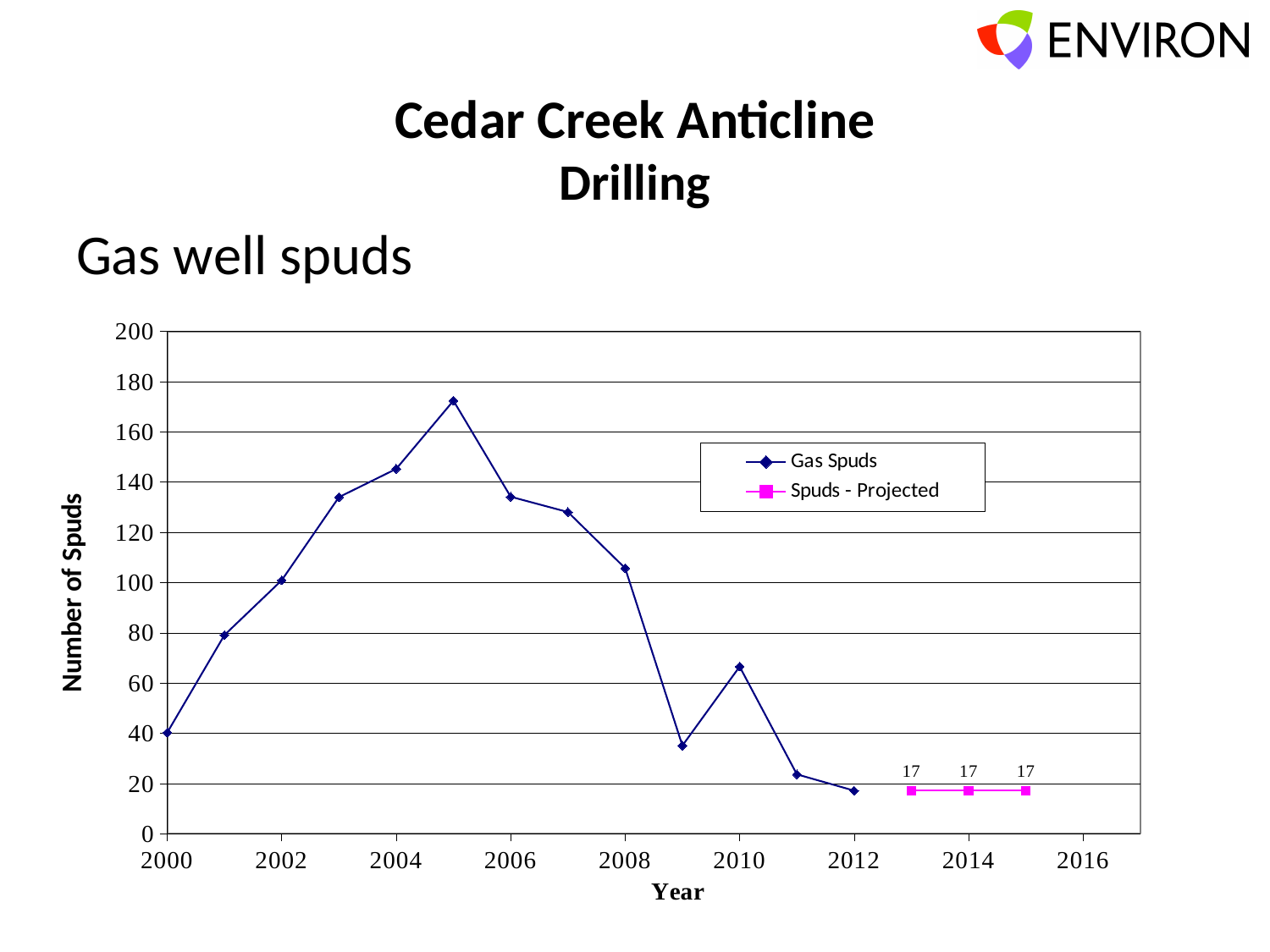
Is the Gas Spuds value for 2009 greater or less than 40? less What is the projected number of spuds for 2014? 17 What type of chart is shown on the slide? line chart Do the Gas Spuds values rise or fall between 2005 and 2009? fall How many series does the legend list? 2 In which year does the Gas Spuds series reach its highest value? 2005 In which year is the Gas Spuds value lowest? 2012 What is the projected number of spuds for 2015? 17 Is the Gas Spuds value for 2005 greater or less than 160? greater Which year has the larger Gas Spuds value, 2004 or 2006? 2004 What are the two series named in the legend? Gas Spuds; Spuds - Projected How many data points are plotted for the Spuds - Projected series? 3